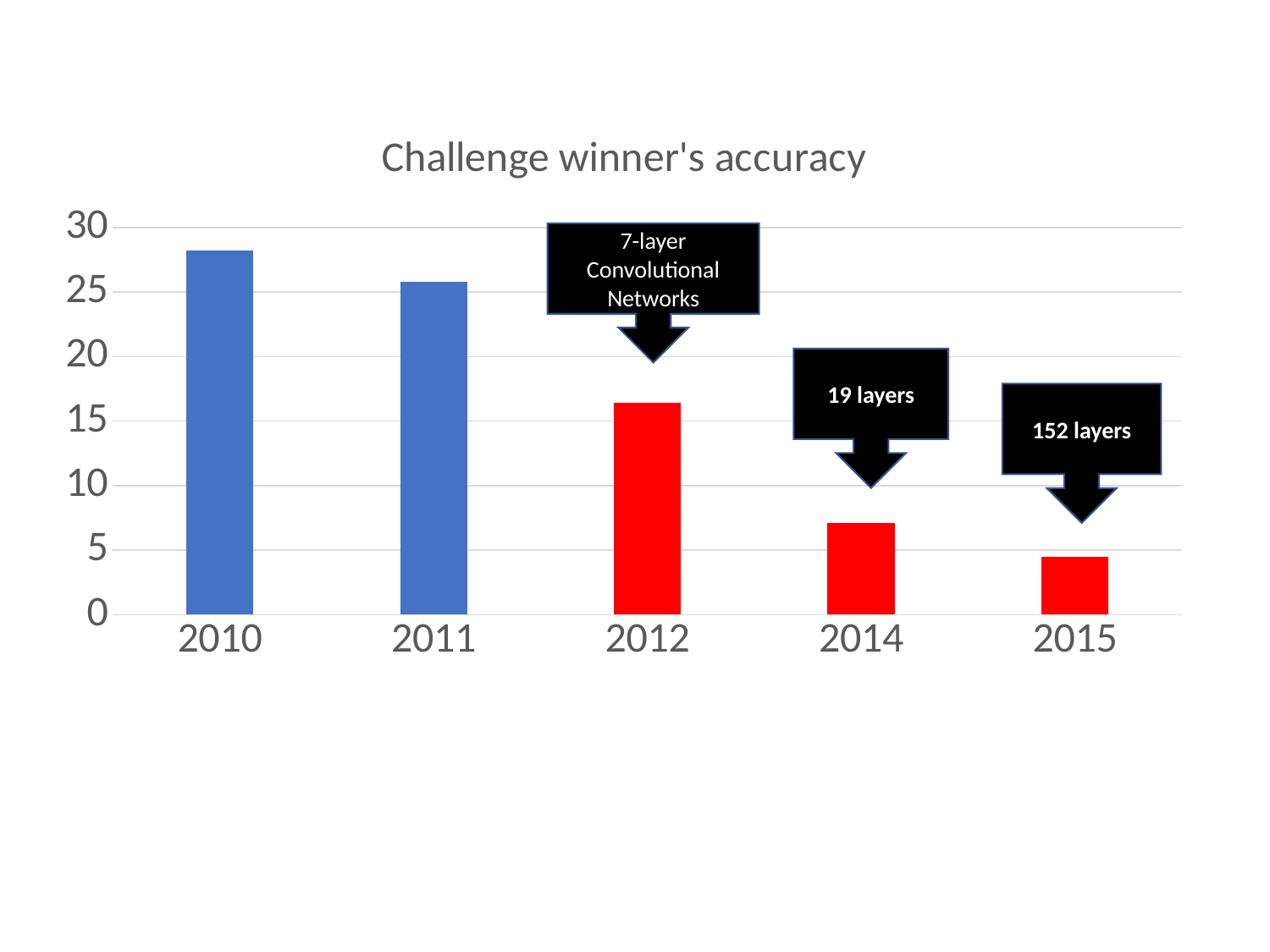
What label is shown in the callout above the 2015 bar? 152 layers What is the title of the chart? Challenge winner's accuracy Is the value for 2014 greater or less than 10? less Which year has the lowest bar in the chart? 2015 Do the values rise or fall from 2010 to 2015 along the x axis? fall Which is larger, the value for 2014 or the value for 2015? 2014 Is the value for 2012 greater or less than 20? less How many years are shown on the x axis of the chart? 5 Which year has the highest bar in the chart? 2010 Which is larger, the value for 2011 or the value for 2012? 2011 Is the value for 2010 greater or less than 25? greater What kind of chart is shown on the slide? bar chart